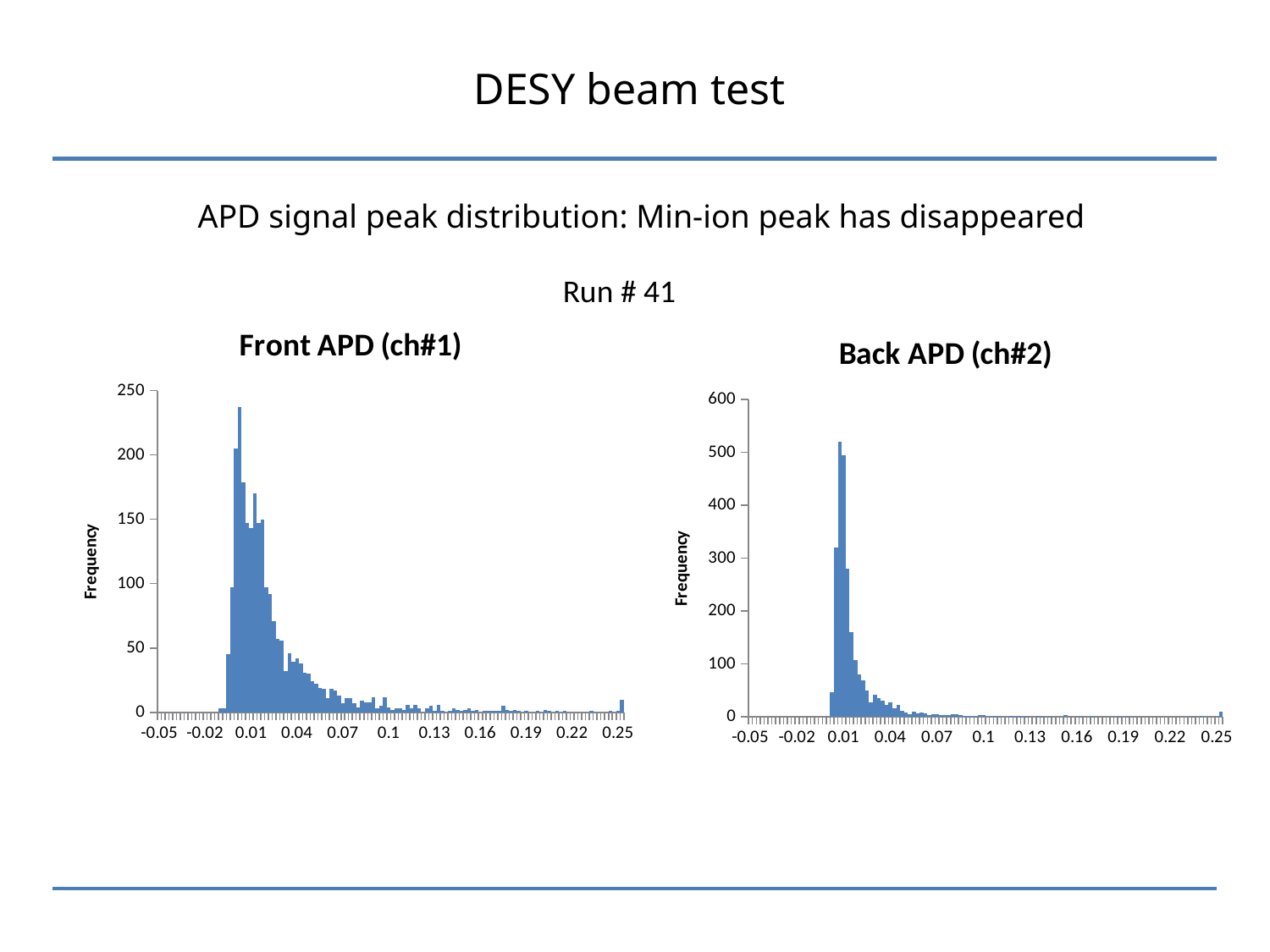
In the Front APD (ch#1) chart, do the bar heights generally rise or fall from 0.04 to 0.22 along the x axis? fall What is the highest value shown on the y axis of the Back APD (ch#2) chart? 600 What kind of chart is the Back APD (ch#2) chart? bar chart In the Front APD (ch#1) chart, is the tallest bar greater or less than 200? greater What kind of chart is the Front APD (ch#1) chart? bar chart In the Front APD (ch#1) chart, is the bar at 0.1 greater or less than 50? less In the Back APD (ch#2) chart, is the bar at 0.07 greater or less than 100? less What is the y-axis label of the Front APD (ch#1) chart? Frequency Which chart has the taller peak bar, Front APD (ch#1) or Back APD (ch#2)? Back APD (ch#2)